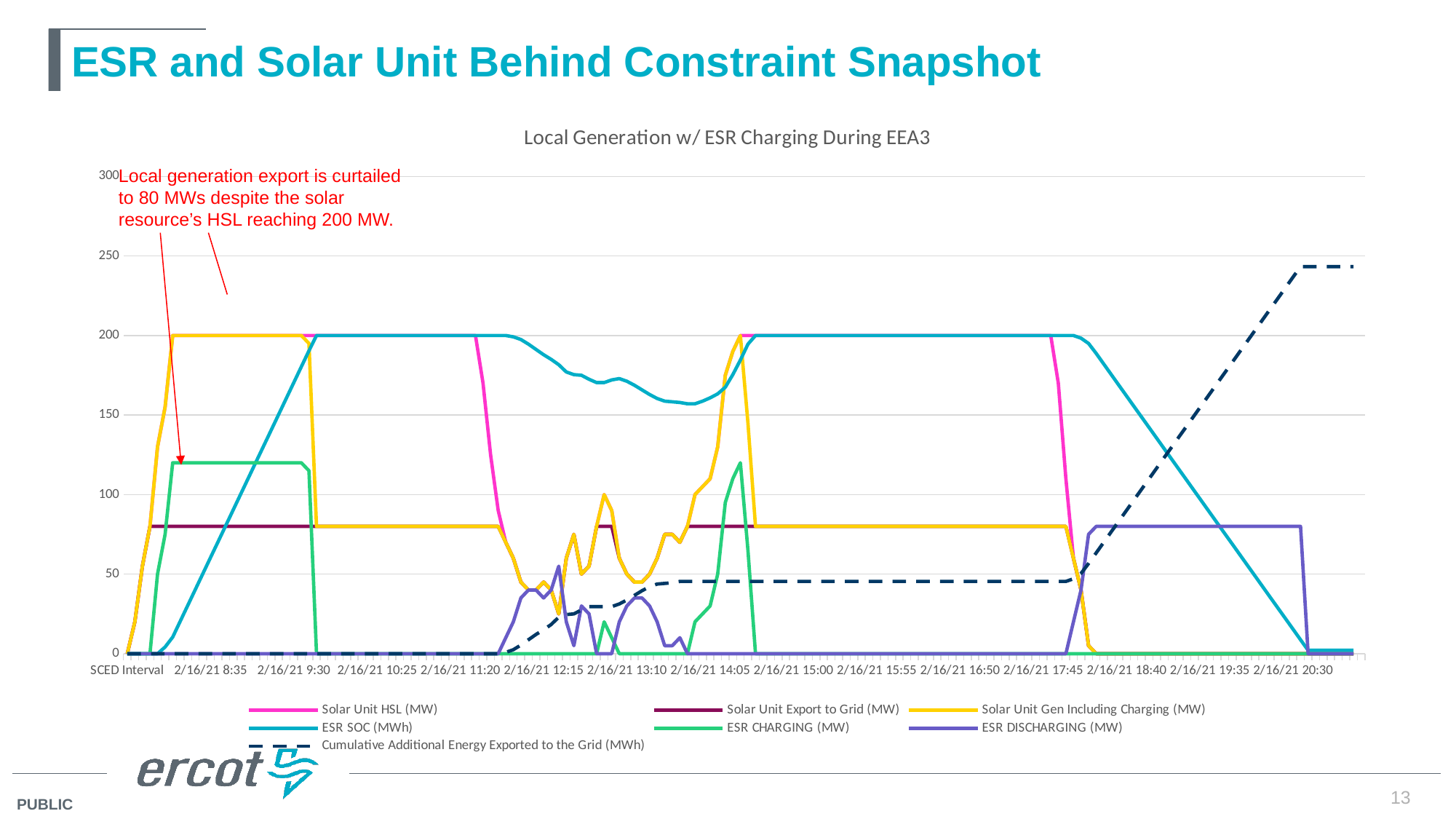
Does the ESR SOC (MWh) line rise or fall between 2/16/21 18:40 and 2/16/21 20:30? fall Is the value of ESR SOC (MWh) at 2/16/21 10:25 greater or less than 150? greater Is the value of Solar Unit Export to Grid (MW) at 2/16/21 15:00 greater or less than 100? less What kind of chart is shown on the slide? line chart What is the title of the chart? Local Generation w/ ESR Charging During EEA3 How many series does the chart legend list? 7 Is the value of Cumulative Additional Energy Exported to the Grid (MWh) at 2/16/21 20:30 greater or less than 200? greater Which series has the highest value at the right end of the chart (2/16/21 20:30)? Cumulative Additional Energy Exported to the Grid (MWh) Which series is drawn with a dashed line in the chart? Cumulative Additional Energy Exported to the Grid (MWh) At 2/16/21 10:25, which is larger: ESR SOC (MWh) or ESR CHARGING (MW)? ESR SOC (MWh)